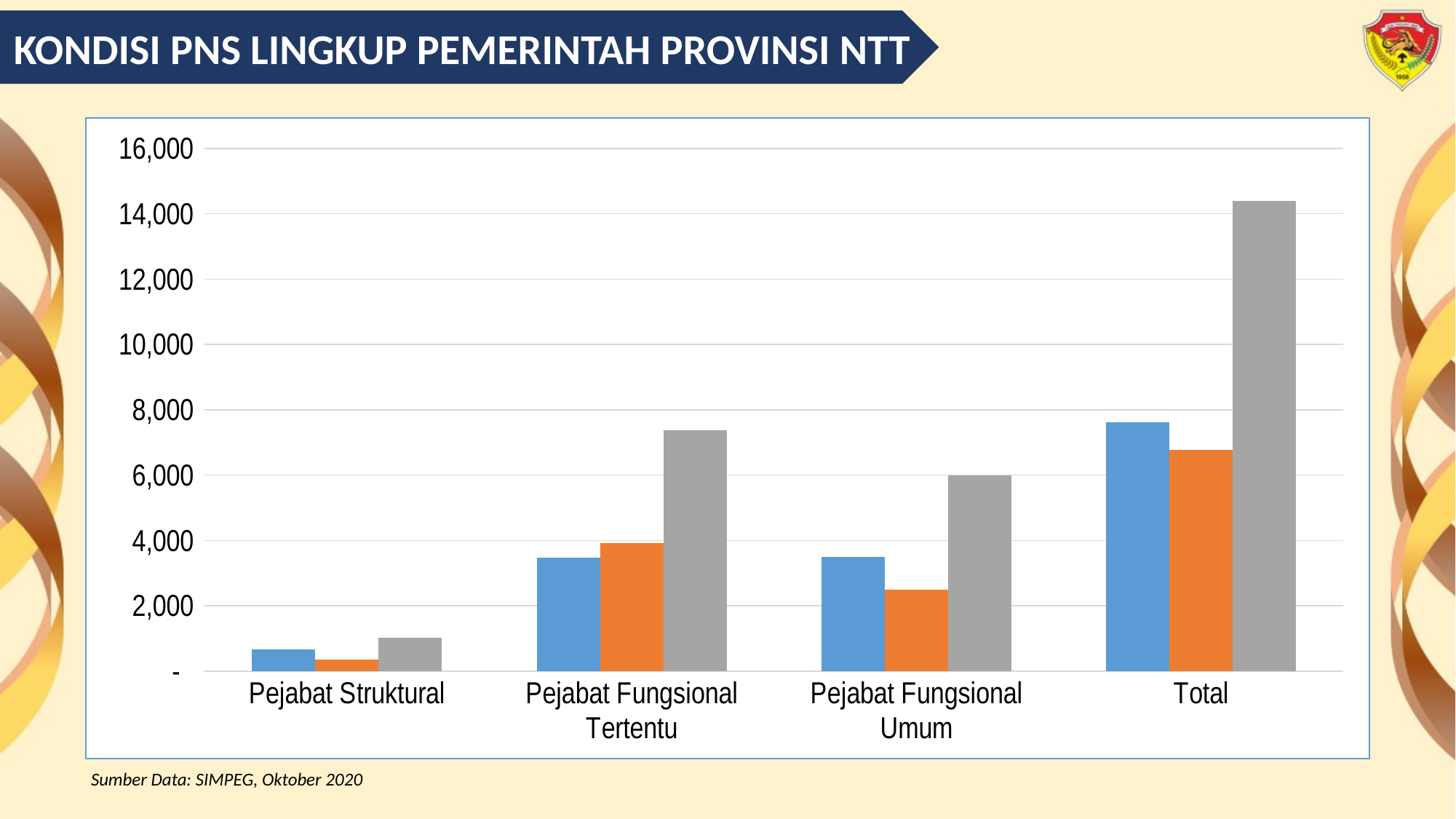
In the Pejabat Fungsional Umum category, which is larger, the blue bar or the orange bar? The blue bar Is the blue bar for Total greater or less than 8,000? less Is the orange bar for Pejabat Struktural greater or less than 2,000? less Excluding Total, which category has the tallest gray bar? Pejabat Fungsional Tertentu How many bars are plotted for each category in the chart? 3 Is the gray bar for Total greater or less than 12,000? greater What data source is cited below the chart? SIMPEG, Oktober 2020 In the Pejabat Fungsional Tertentu category, which is larger, the blue bar or the orange bar? The orange bar Which category has the tallest gray bar? Total What kind of chart is shown on the slide? Bar chart How many categories are shown on the x axis of the chart? 4 Which category has the shortest gray bar? Pejabat Struktural